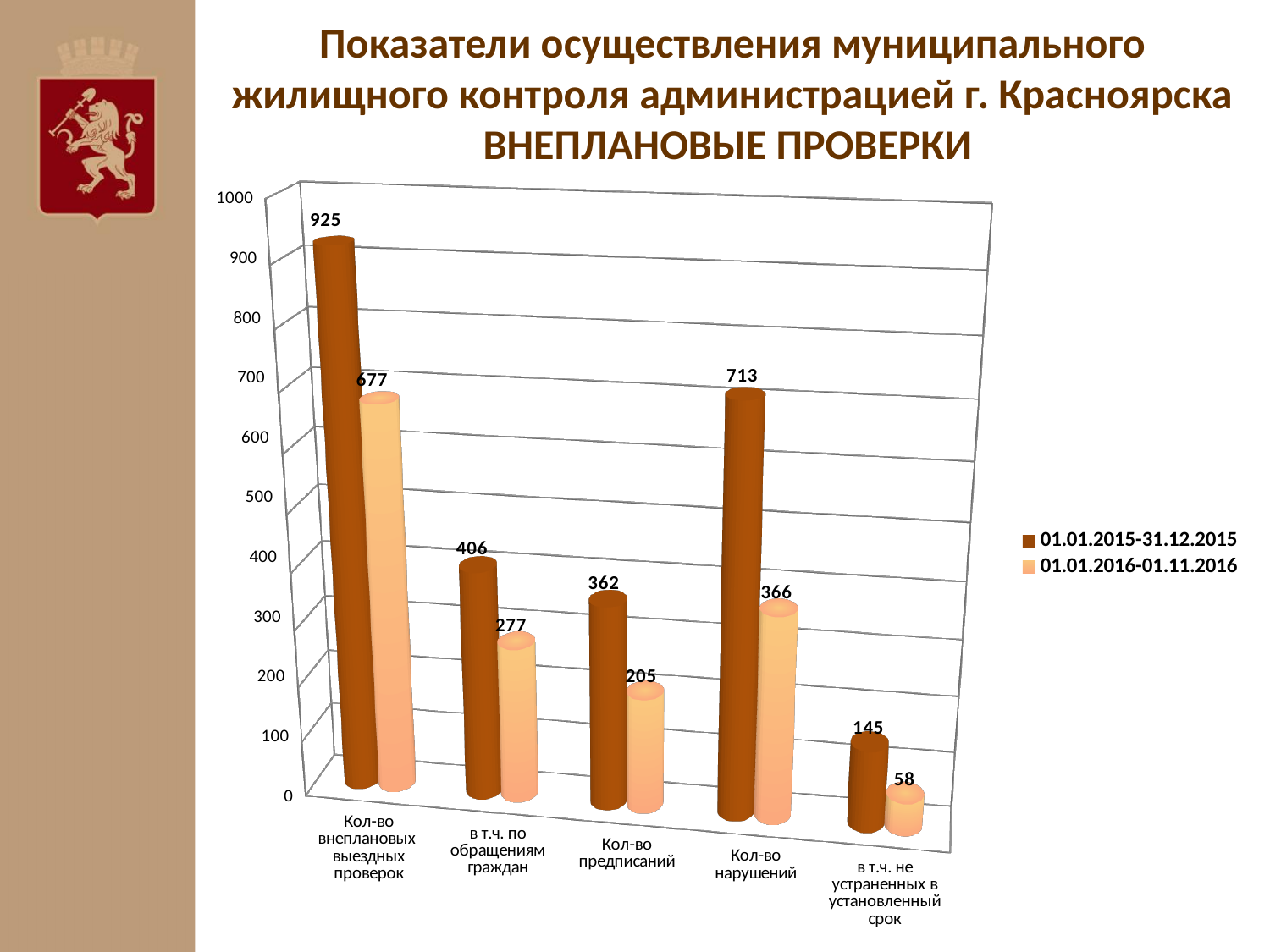
Which is larger: the 01.01.2015-31.12.2015 value for "в т.ч. по обращениям граждан" or the 01.01.2016-01.11.2016 value for "Кол-во нарушений"? 01.01.2015-31.12.2015 value for "в т.ч. по обращениям граждан" What is the value for "в т.ч. не устраненных в установленный срок" in the 01.01.2016-01.11.2016 series? 58 What kind of chart is shown on the slide? Bar chart Which series is shown in dark brown in the legend? 01.01.2015-31.12.2015 Which category has the lowest value in the 01.01.2016-01.11.2016 series? в т.ч. не устраненных в установленный срок Which category has the highest value in the 01.01.2015-31.12.2015 series? Кол-во внеплановых выездных проверок How many series does the legend list? 2 What is the value for "Кол-во внеплановых выездных проверок" in the 01.01.2015-31.12.2015 series? 925 How many categories are shown on the x axis? 5 What is the difference between the 01.01.2015-31.12.2015 and 01.01.2016-01.11.2016 values for "Кол-во предписаний"? 157 What is the value for "Кол-во нарушений" in the 01.01.2016-01.11.2016 series? 366 What is the difference between the 01.01.2015-31.12.2015 and 01.01.2016-01.11.2016 values for "Кол-во нарушений"? 347